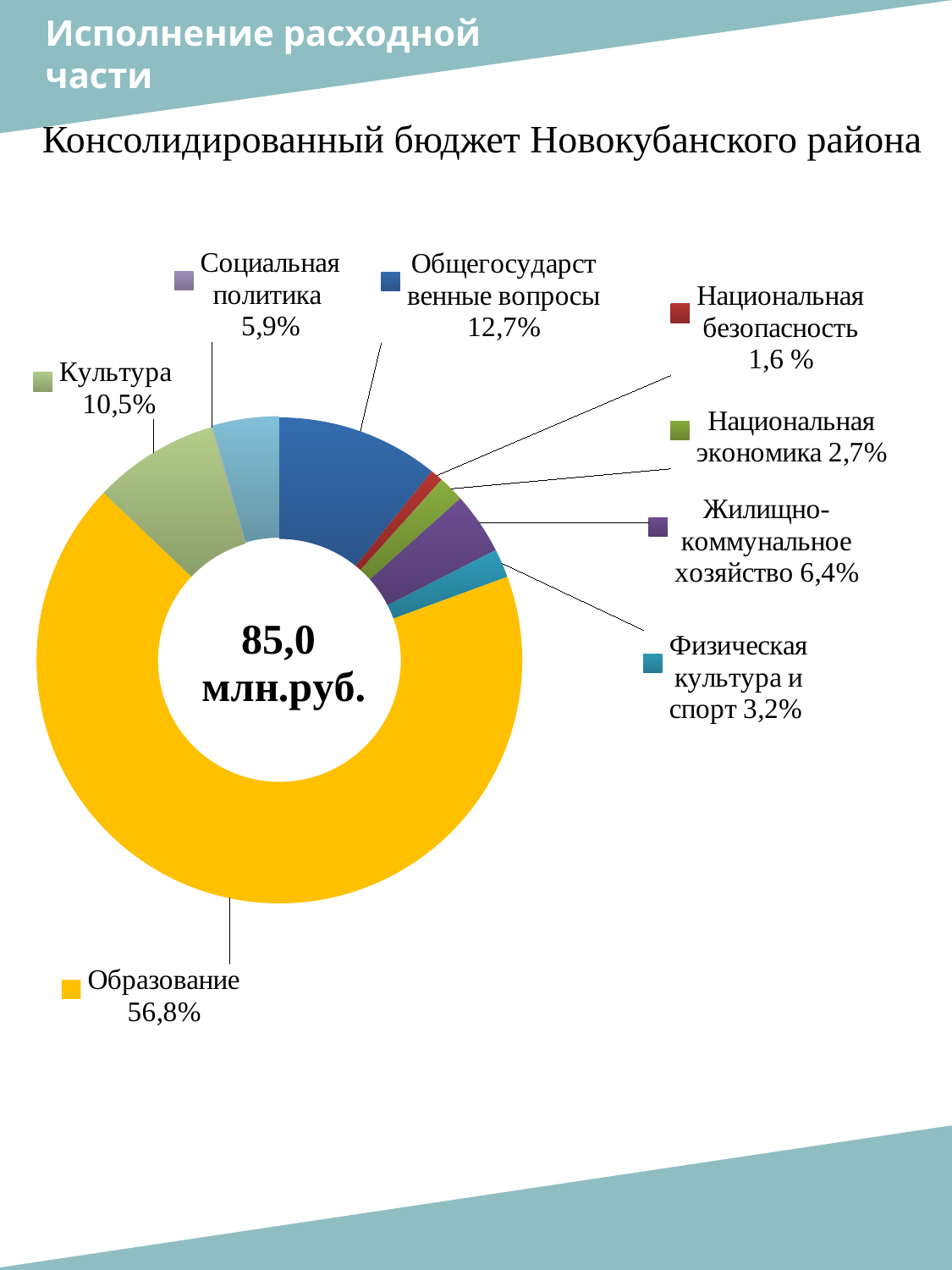
What colour is the segment for Образование? Yellow What kind of chart is shown on the slide? Doughnut (pie) chart What share of the chart does Образование account for? 56,8% Which is larger, the share for Национальная экономика or the share for Физическая культура и спорт? Физическая культура и спорт How many categories are shown in the chart? 8 What is the difference in percentage points between Культура and Социальная политика? 4,6 What is the value for Физическая культура и спорт? 3,2% What is the value shown for Общегосударственные вопросы? 12,7% What total amount is printed in the centre of the chart? 85,0 млн.руб. Which category has the smallest share of the chart? Национальная безопасность Which category has the largest share of the chart? Образование What percentage is shown for Жилищно-коммунальное хозяйство? 6,4%